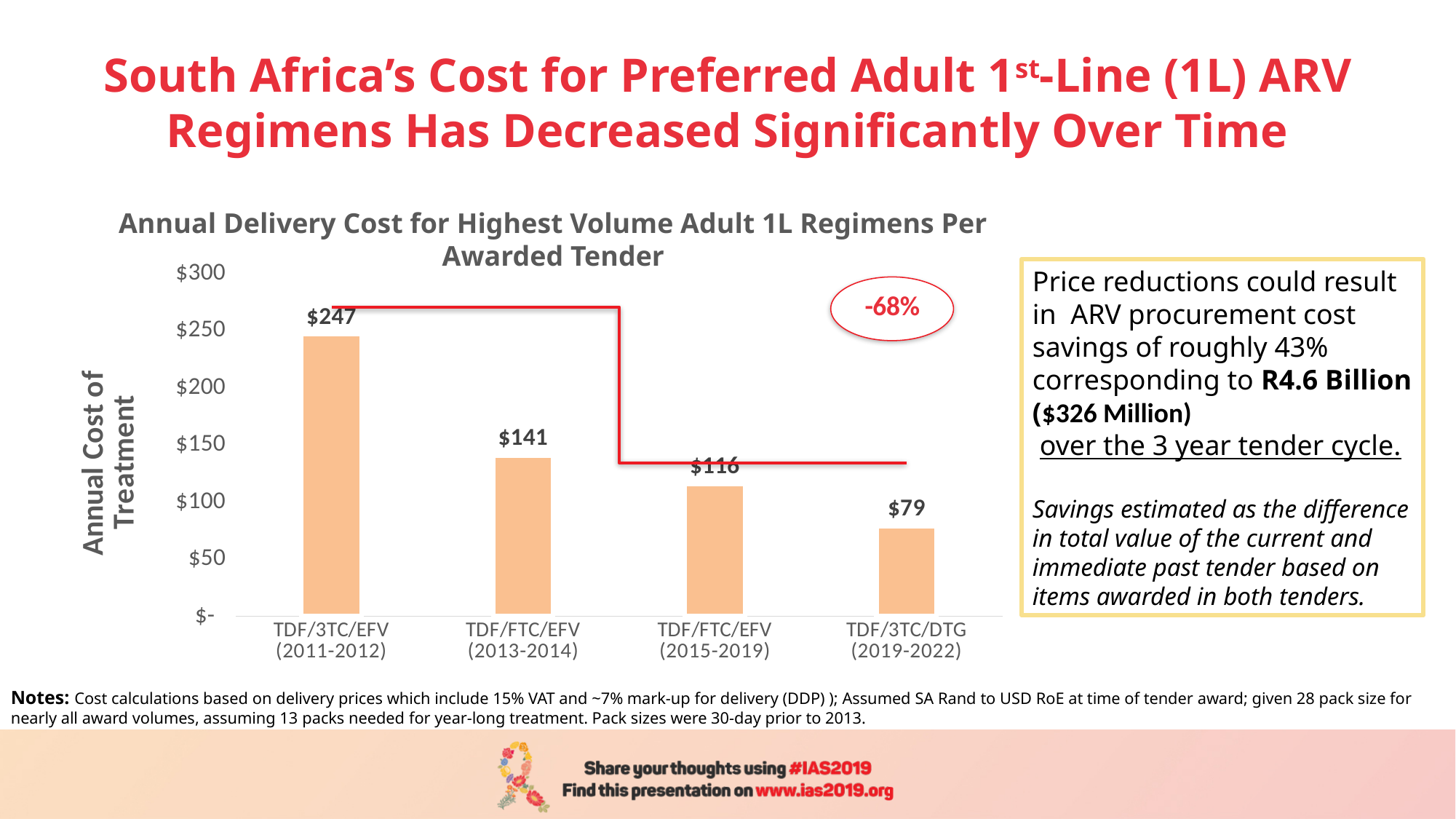
What is the difference in annual cost between TDF/3TC/EFV (2011-2012) and TDF/3TC/DTG (2019-2022)? $168 Do the annual costs rise or fall across the tenders from left to right? Fall What type of chart is used to show the annual delivery cost? Bar chart What is the annual cost of treatment for TDF/FTC/EFV (2015-2019)? $116 How many regimens (bars) are shown in the chart? 4 Which has a higher annual cost of treatment, TDF/FTC/EFV (2013-2014) or TDF/FTC/EFV (2015-2019)? TDF/FTC/EFV (2013-2014) What is the annual cost of treatment for TDF/FTC/EFV (2013-2014)? $141 Which regimen has the lowest annual cost of treatment? TDF/3TC/DTG (2019-2022) What is the annual cost of treatment for TDF/3TC/DTG (2019-2022)? $79 What is the annual cost of treatment for TDF/3TC/EFV (2011-2012)? $247 Which regimen has the highest annual cost of treatment? TDF/3TC/EFV (2011-2012) What percentage reduction is shown in the red oval on the chart? -68%